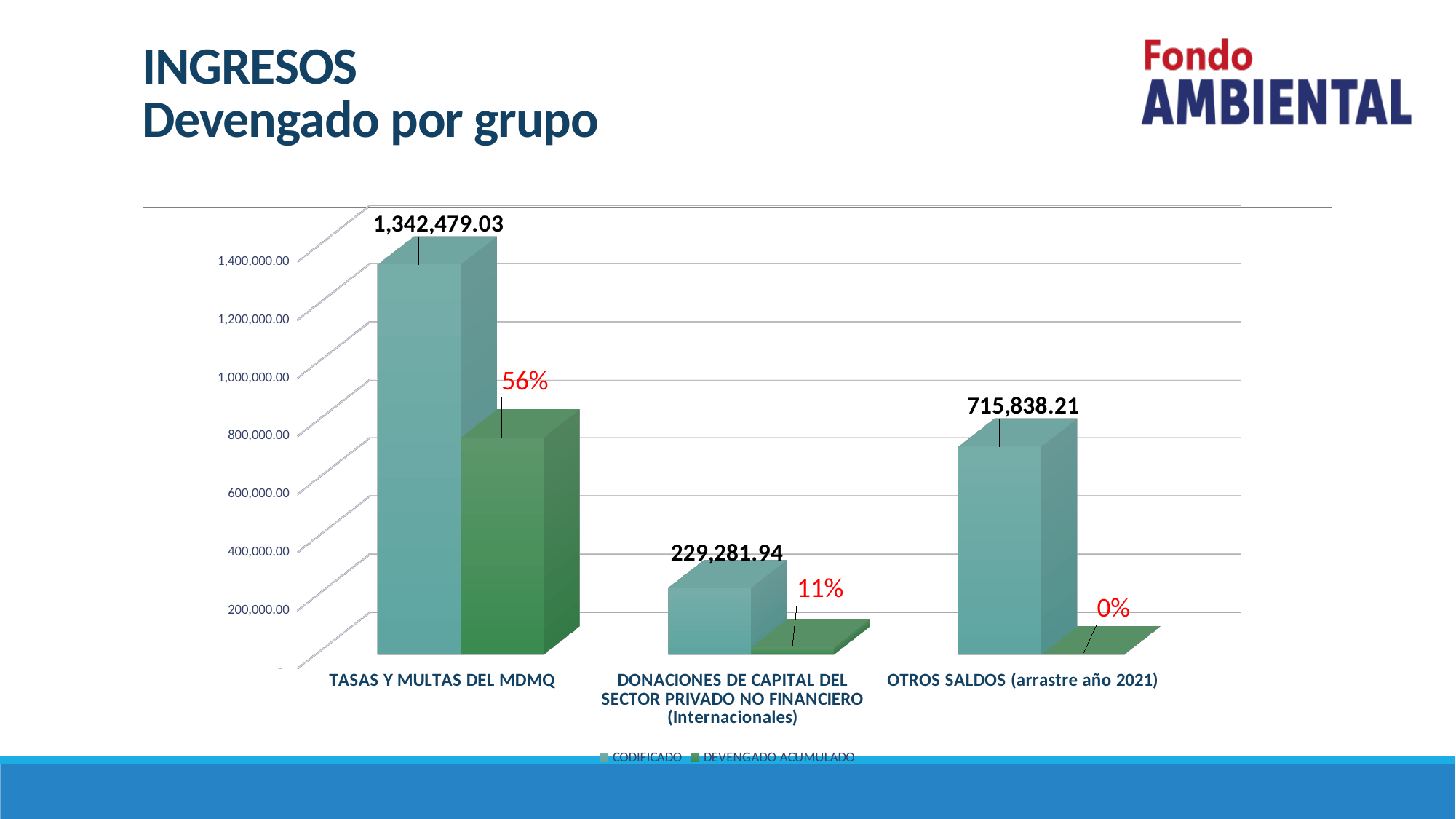
What percentage label is shown on the DEVENGADO ACUMULADO bar for OTROS SALDOS (arrastre año 2021)? 0% How many series does the legend list? 2 What is the CODIFICADO value for TASAS Y MULTAS DEL MDMQ? 1,342,479.03 What is the difference between the CODIFICADO values for TASAS Y MULTAS DEL MDMQ and OTROS SALDOS (arrastre año 2021)? 626,640.82 Which category has the lowest CODIFICADO value? DONACIONES DE CAPITAL DEL SECTOR PRIVADO NO FINANCIERO (Internacionales) What is the CODIFICADO value for DONACIONES DE CAPITAL DEL SECTOR PRIVADO NO FINANCIERO (Internacionales)? 229,281.94 Which has a larger CODIFICADO value: OTROS SALDOS (arrastre año 2021) or DONACIONES DE CAPITAL DEL SECTOR PRIVADO NO FINANCIERO (Internacionales)? OTROS SALDOS (arrastre año 2021) Is the DEVENGADO ACUMULADO value for TASAS Y MULTAS DEL MDMQ greater or less than 1,000,000.00? less How many categories are shown on the x axis of the chart? 3 What percentage label is shown on the DEVENGADO ACUMULADO bar for TASAS Y MULTAS DEL MDMQ? 56% What is the CODIFICADO value for OTROS SALDOS (arrastre año 2021)? 715,838.21 Which category has the highest CODIFICADO value? TASAS Y MULTAS DEL MDMQ